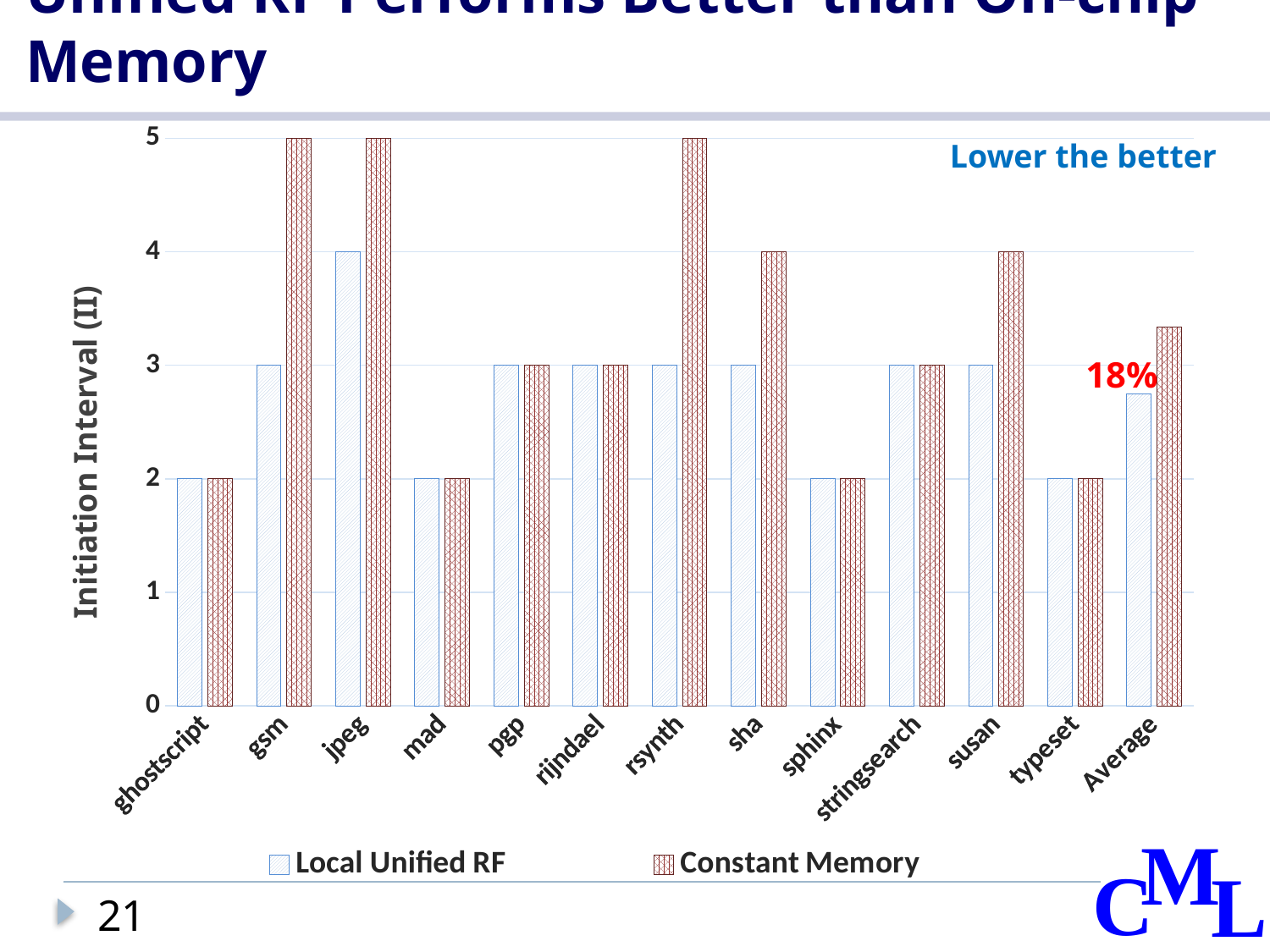
What is the difference between the Constant Memory and Local Unified RF values for rsynth? 2 How many categories are shown along the x axis? 13 Which is larger for susan, the Local Unified RF value or the Constant Memory value? Constant Memory What is the Constant Memory value for gsm? 5 What percentage label is printed above the Average bars? 18% What kind of chart is shown on the slide? bar chart How many series does the legend list? 2 What is the Constant Memory value for sha? 4 Which category has the highest Local Unified RF value? jpeg What is the label of the y axis? Initiation Interval (II) What is the Local Unified RF value for jpeg? 4 Is the Constant Memory value for Average greater or less than 3? greater